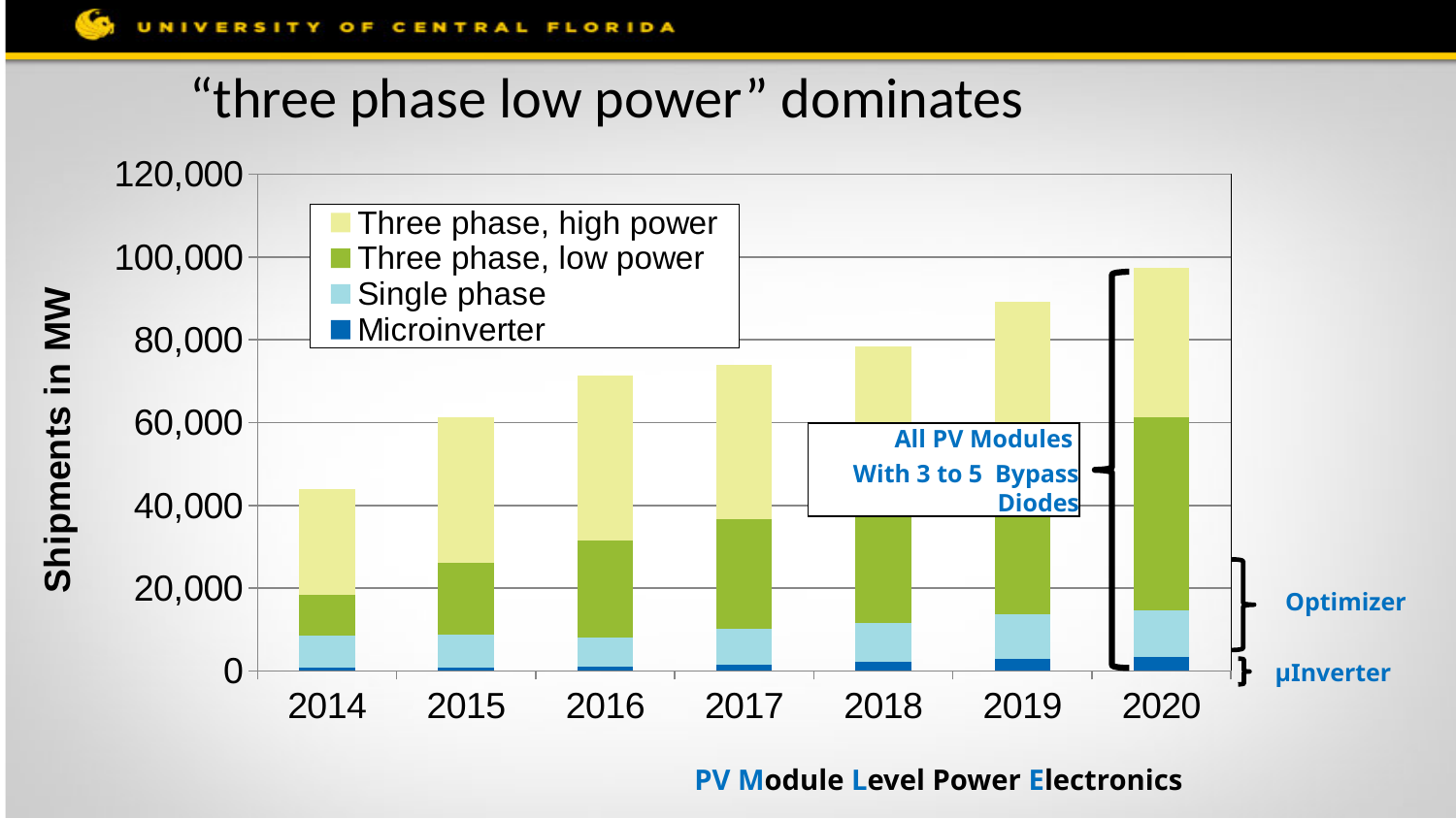
Which legend entry is shown in the darkest blue colour at the bottom of each bar? Microinverter Is the total shipments value for 2020 greater or less than 80,000? greater Is the total shipments value for 2014 greater or less than 60,000? less Is the total shipments value for 2016 greater or less than 60,000? greater Which year has the lowest total shipments in the chart? 2014 Do total shipments rise or fall from 2014 to 2020? Rise What kind of chart is shown on the slide? Stacked bar chart Which year has the highest total shipments in the chart? 2020 What is the label on the y axis of the chart? Shipments in MW How many years are shown along the x axis of the chart? 7 How many series does the chart's legend list? 4 Which year has larger total shipments, 2014 or 2020? 2020